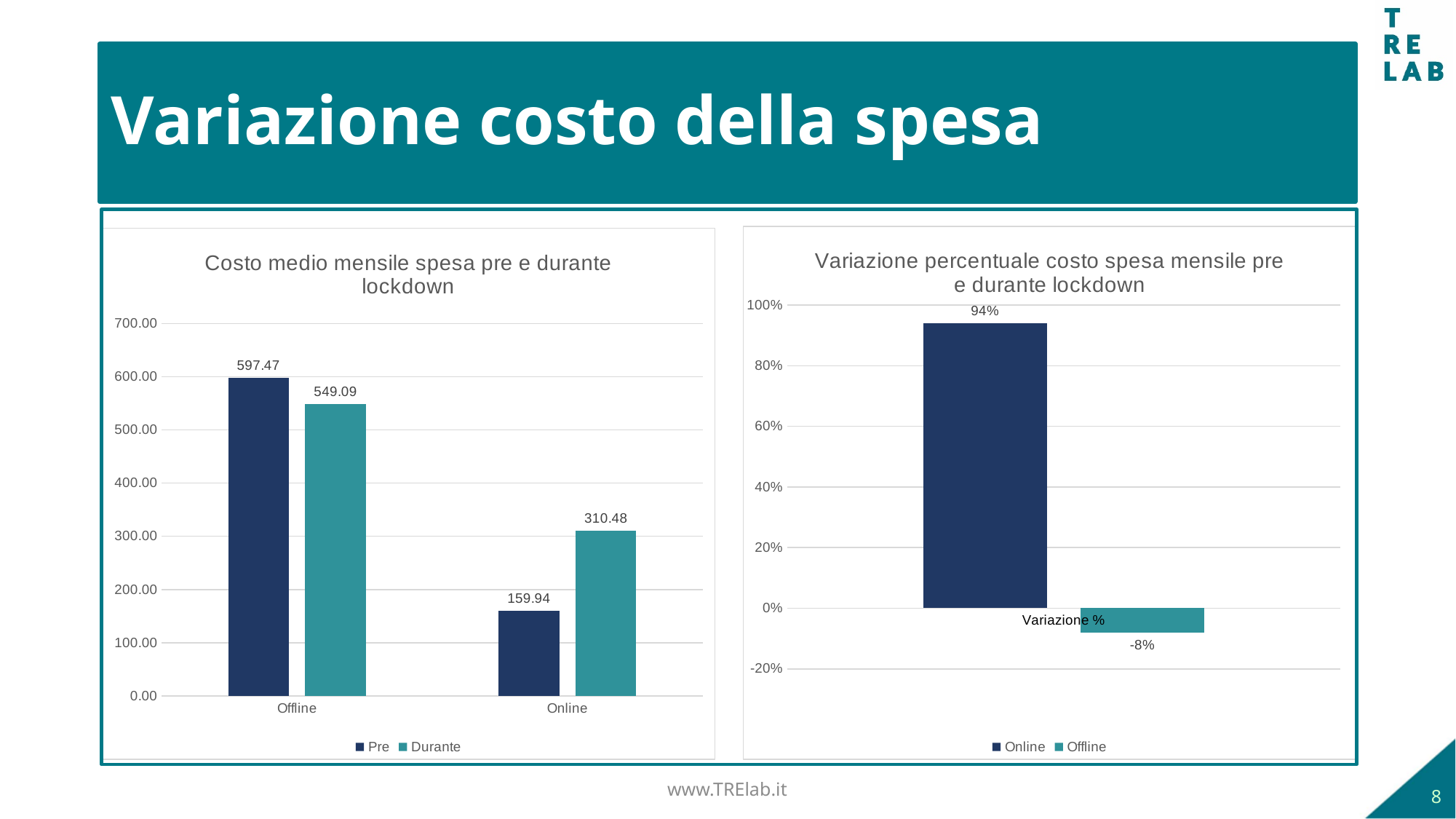
In the left chart, 'Costo medio mensile spesa pre e durante lockdown', what is the Pre value for Online? 159.94 In the right chart, 'Variazione percentuale costo spesa mensile pre e durante lockdown', which series has the lowest value? Offline In the left chart, 'Costo medio mensile spesa pre e durante lockdown', how many categories are shown on the x axis? 2 In the right chart, 'Variazione percentuale costo spesa mensile pre e durante lockdown', what is the value for Offline? -8% In the left chart, 'Costo medio mensile spesa pre e durante lockdown', what is the Durante value for Online? 310.48 In the right chart, 'Variazione percentuale costo spesa mensile pre e durante lockdown', what is the value for Online? 94% In the left chart, 'Costo medio mensile spesa pre e durante lockdown', which is larger for Online: the Pre value or the Durante value? Durante What kind of chart is the right chart, 'Variazione percentuale costo spesa mensile pre e durante lockdown'? Bar chart In the left chart, 'Costo medio mensile spesa pre e durante lockdown', how many series does the legend list? 2 In the left chart, 'Costo medio mensile spesa pre e durante lockdown', which bar has the highest value? Offline Pre In the left chart, 'Costo medio mensile spesa pre e durante lockdown', what is the Pre value for Offline? 597.47 In the left chart, 'Costo medio mensile spesa pre e durante lockdown', what is the difference between the Pre and Durante values for Offline? 48.38